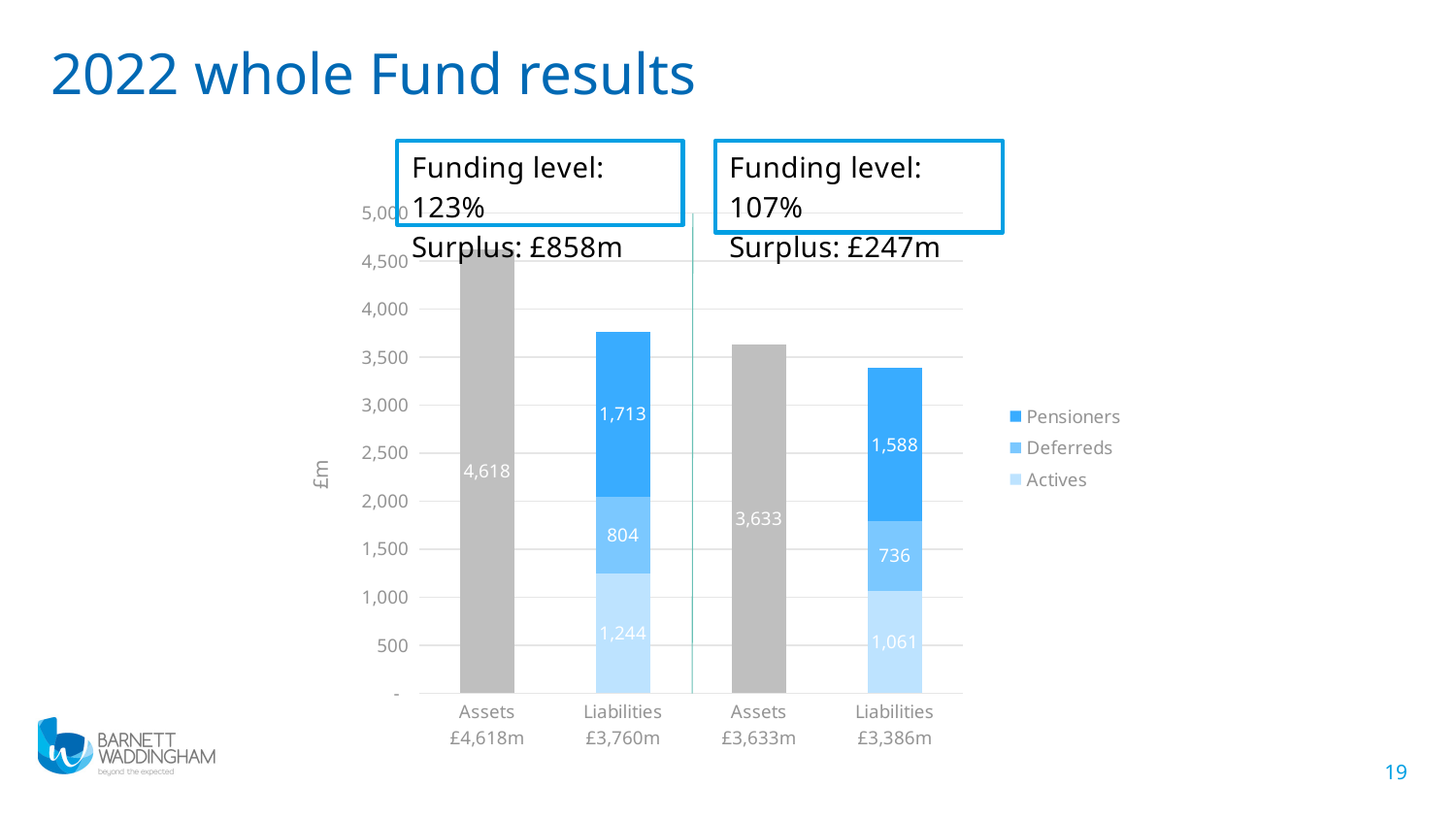
What kind of chart is shown on the slide? Stacked bar chart What is the value of the Deferreds segment in the right-hand Liabilities bar? 736 Which bar is the tallest on the chart? Assets (£4,618m) What is the label on the vertical axis? £m What is the value shown on the left-hand Assets bar? 4,618 Which bar is the shortest on the chart? Liabilities (£3,386m) What is the total of the left-hand Liabilities bar, as labelled on the axis? £3,760m What is the value of the Actives segment in the right-hand Liabilities bar? 1,061 What is the difference between the Deferreds segments of the two Liabilities bars (804 and 736)? 68 How many series does the legend list? 3 Which is larger: the Pensioners segment in the left-hand Liabilities bar or the Pensioners segment in the right-hand Liabilities bar? Left-hand Liabilities bar (1,713) What is the value of the Pensioners segment in the left-hand Liabilities bar? 1,713